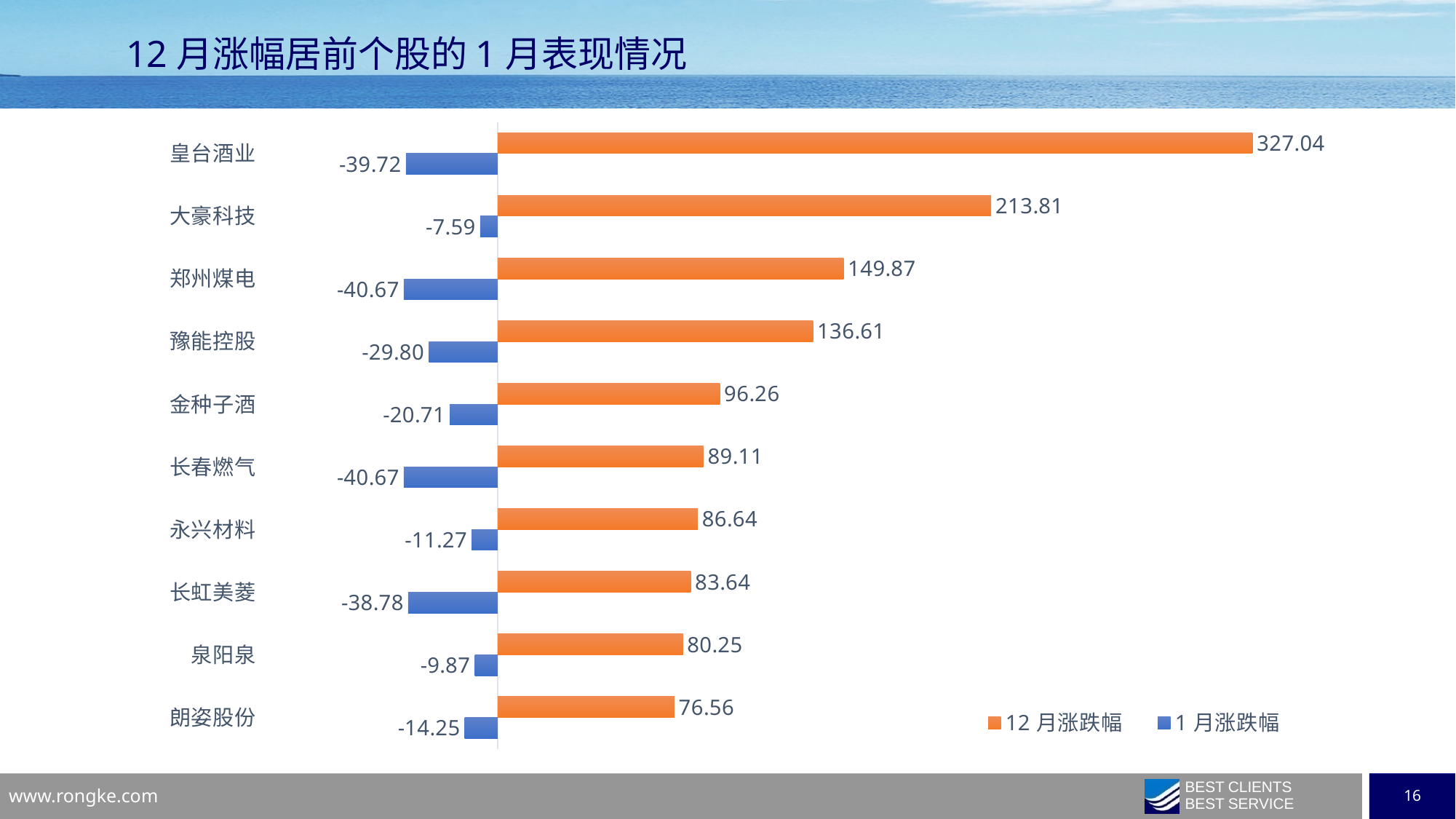
How many stocks are shown in the chart? 10 Which stock has the highest 12 月涨跌幅? 皇台酒业 What is the 1 月涨跌幅 value for 朗姿股份? -14.25 What is the difference between the 12 月涨跌幅 of 皇台酒业 and 大豪科技? 113.23 Which stock has the lowest 12 月涨跌幅? 朗姿股份 What is the 12 月涨跌幅 value for 皇台酒业? 327.04 Which stock has the highest (least negative) 1 月涨跌幅? 大豪科技 What is the 12 月涨跌幅 value for 郑州煤电? 149.87 How many series does the legend list? 2 Which has a larger 12 月涨跌幅, 金种子酒 or 长春燃气? 金种子酒 What kind of chart is shown on the slide? Bar chart What is the 1 月涨跌幅 value for 大豪科技? -7.59